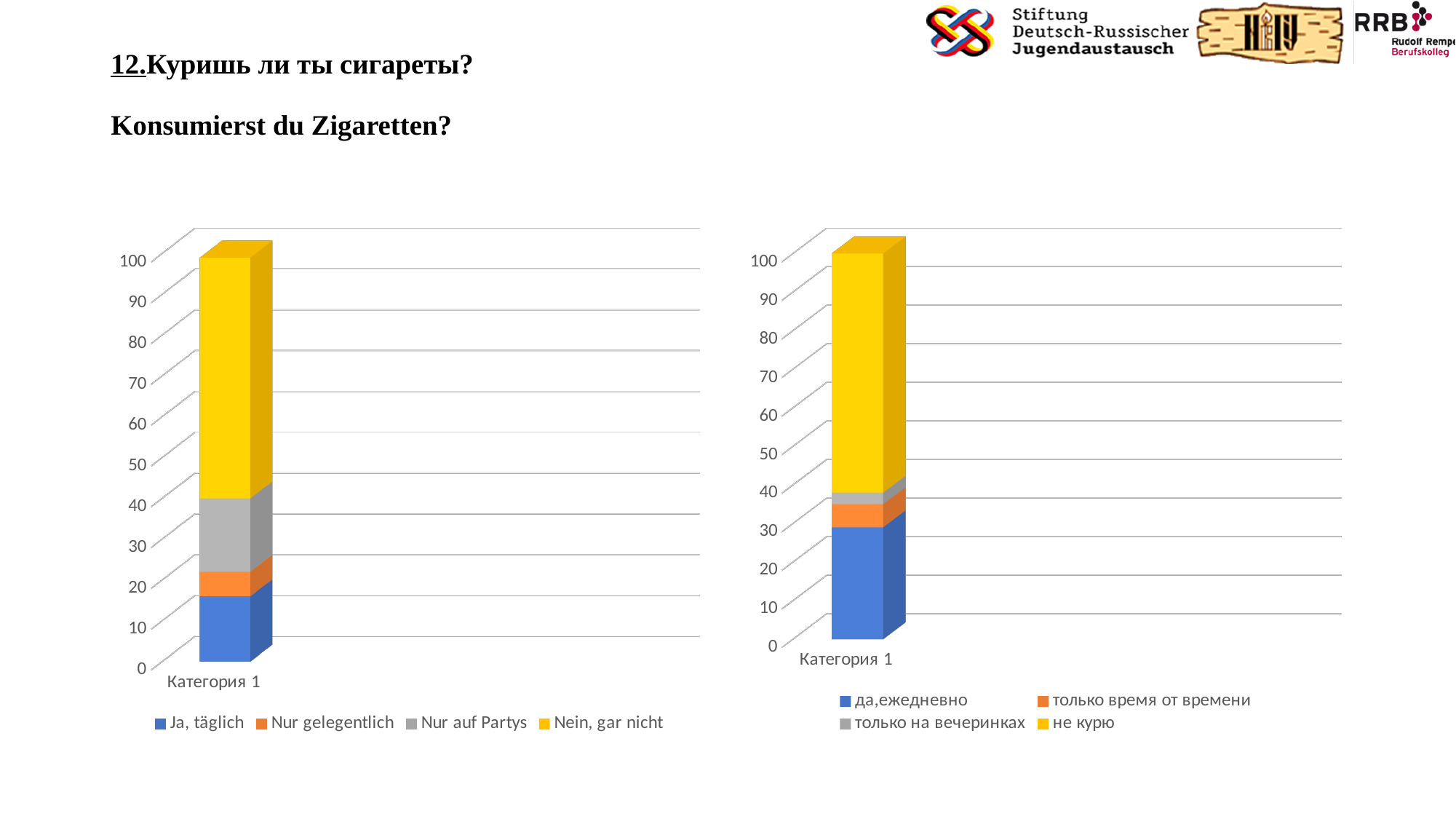
In the right chart, which segment is larger: да,ежедневно or только время от времени? да,ежедневно How many series does the legend of the left chart list? 4 How many series does the legend of the right chart list? 4 What is the label of the category on the x axis of the left chart? Категория 1 In the right chart, which series takes up the largest part of the stacked bar? не курю In the left chart, which series takes up the largest part of the stacked bar? Nein, gar nicht How many categories are shown on the x axis of the right chart? 1 In the left chart, which series takes up the smallest part of the stacked bar? Nur gelegentlich In the left chart, is the value for Ja, täglich greater or less than 20? less What kind of chart is the left chart on the slide? stacked bar chart In the left chart, which segment is larger: Ja, täglich or Nur gelegentlich? Ja, täglich In the right chart, is the value for да,ежедневно greater or less than 20? greater